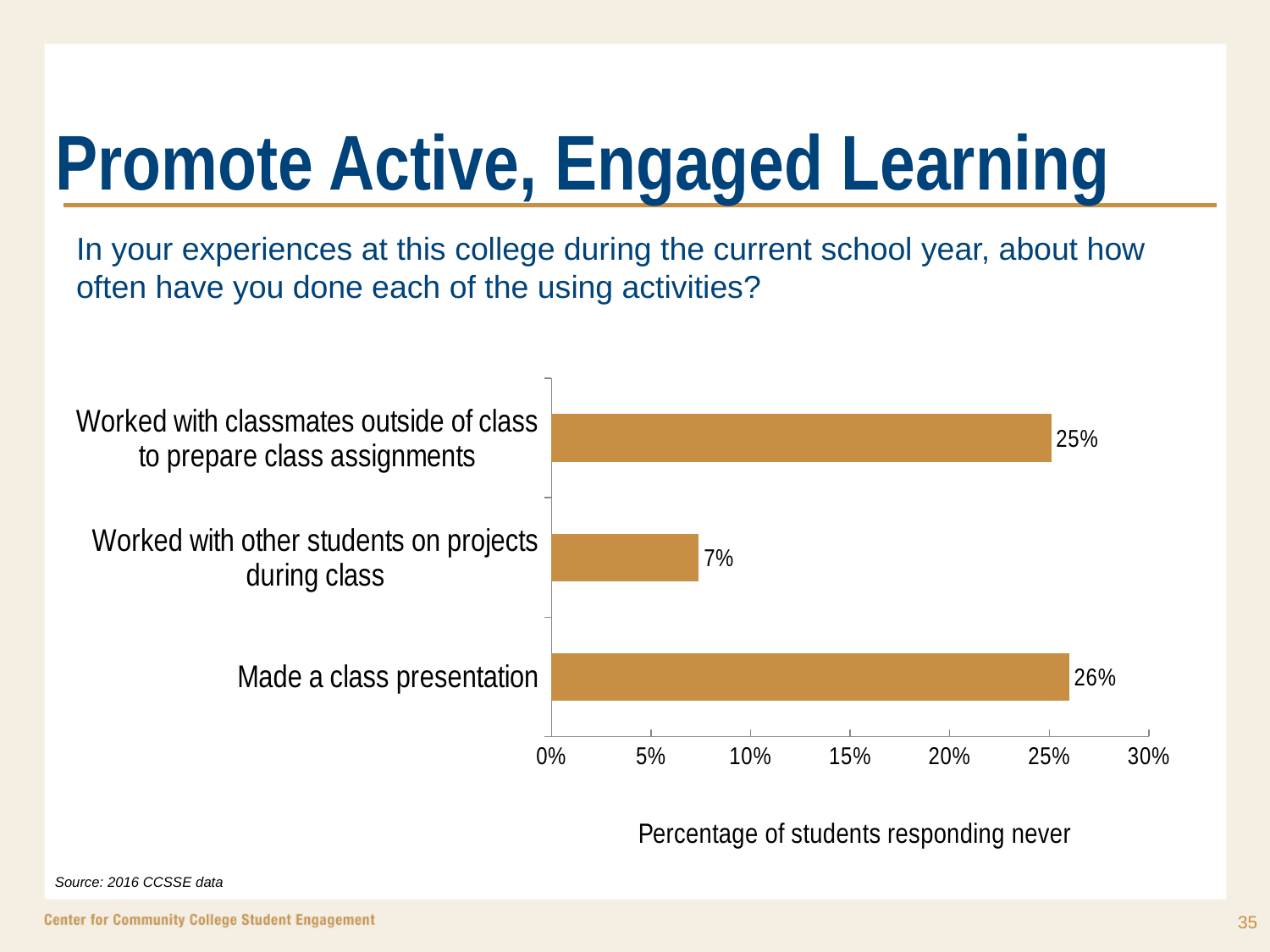
Is the value for 'Worked with other students on projects during class' greater or less than 10%? less How many activities are shown in the chart? 3 What is the difference between the percentage for 'Made a class presentation' and the percentage for 'Worked with other students on projects during class'? 19% What kind of chart is shown on the slide? Bar chart Which is larger: the percentage for 'Worked with classmates outside of class to prepare class assignments' or the percentage for 'Worked with other students on projects during class'? Worked with classmates outside of class to prepare class assignments Which activity has the lowest percentage of students responding never? Worked with other students on projects during class What is the label on the horizontal axis of the chart? Percentage of students responding never Which activity has the highest percentage of students responding never? Made a class presentation What percentage of students responded never for 'Worked with other students on projects during class'? 7% What percentage of students responded never for 'Worked with classmates outside of class to prepare class assignments'? 25% What percentage of students responded never for 'Made a class presentation'? 26% What is the difference between the percentage for 'Worked with classmates outside of class to prepare class assignments' and the percentage for 'Worked with other students on projects during class'? 18%